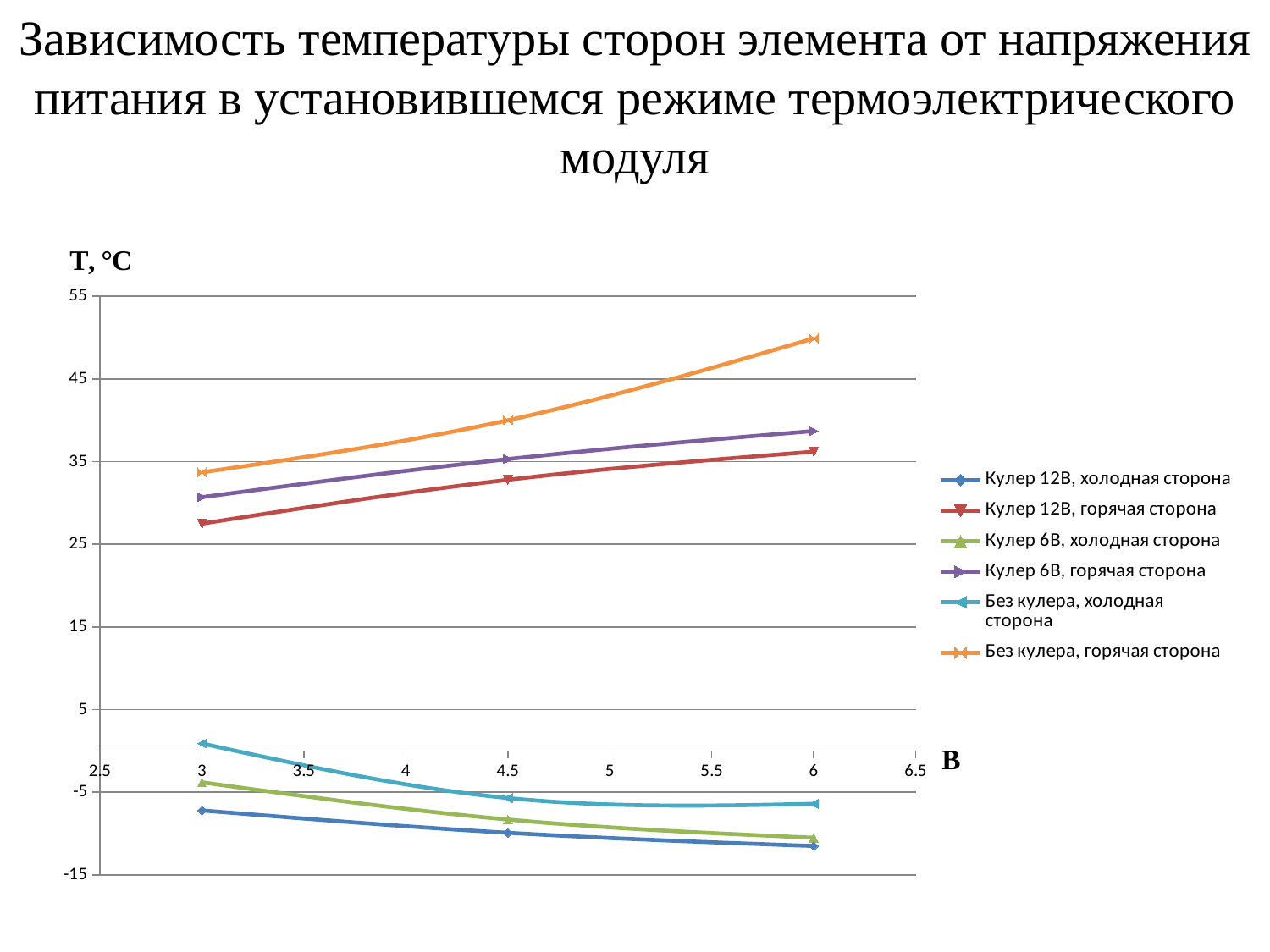
How many series does the legend list? 6 Does the series "Без кулера, горячая сторона" rise or fall as the voltage increases from 3 to 6? rise Which series has the highest value at 6? Без кулера, горячая сторона Is the value for "Без кулера, горячая сторона" at 3 greater or less than 35? less At 6, which is larger: "Без кулера, горячая сторона" or "Кулер 6В, горячая сторона"? Без кулера, горячая сторона Is the value for "Без кулера, горячая сторона" at 6 greater or less than 45? greater Is the value for "Кулер 12В, холодная сторона" at 6 greater or less than -5? less What kind of chart is shown on the slide? line chart Does the series "Кулер 12В, холодная сторона" rise or fall as the voltage increases from 3 to 6? fall Which series has the lowest value at 3? Кулер 12В, холодная сторона How many data points does the series "Без кулера, горячая сторона" have? 3